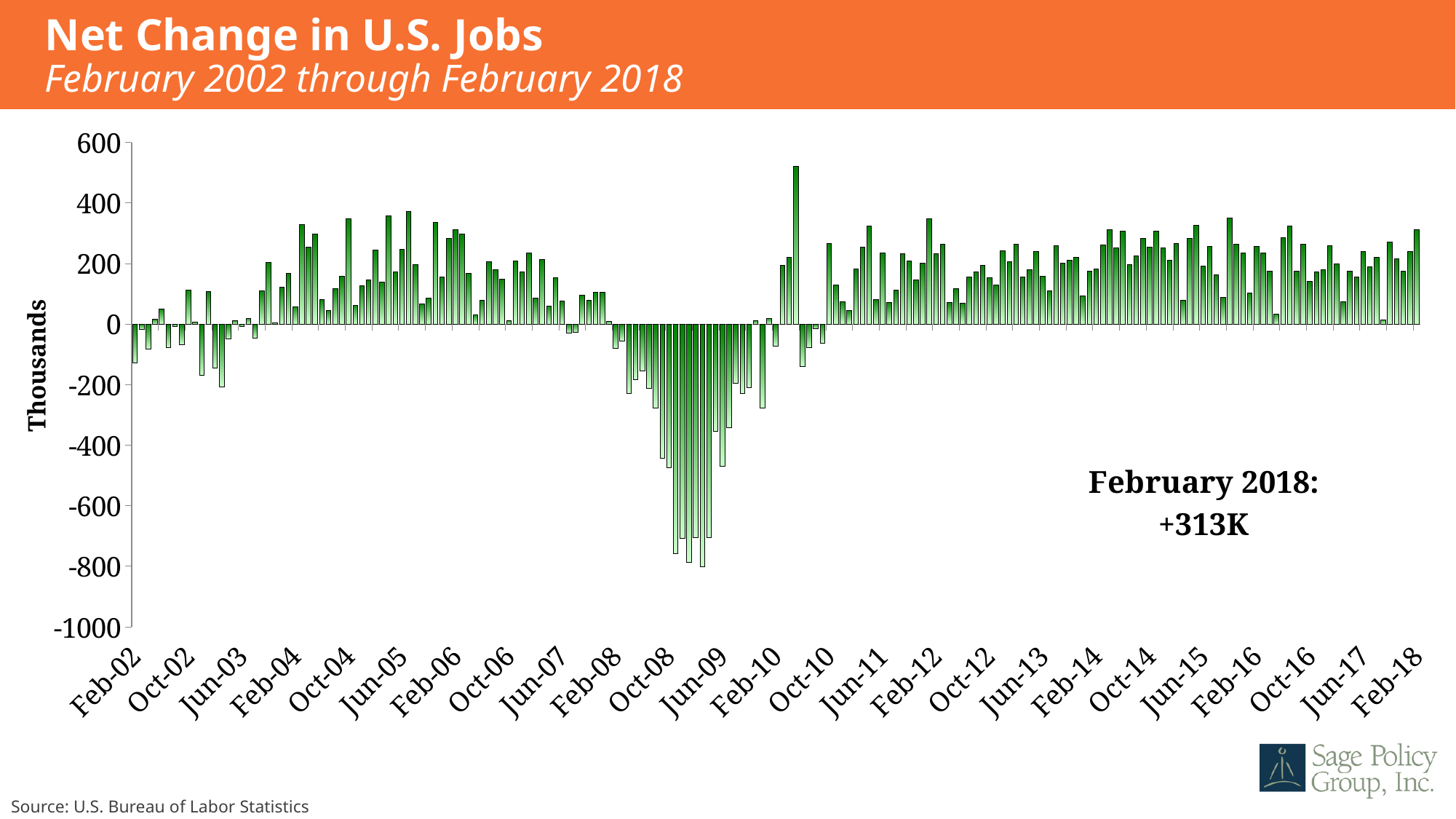
What is the net change in U.S. jobs for February 2018 as printed on the slide? +313K Near which x-axis label do the lowest (most negative) values occur? Jun-09 Which is larger, the value for Feb-18 or the value for Jun-09? Feb-18 Is the lowest bar on the chart greater or less than -600? less Is the tallest bar on the chart greater or less than 400? greater Is the value for Feb-18 greater or less than 200? greater What kind of chart is shown on the slide? bar chart What is the title of the chart? Net Change in U.S. Jobs What is the label on the vertical axis? Thousands How many labels are shown along the x axis? 25 From Jun-09 to Feb-10, do the values generally rise or fall? rise